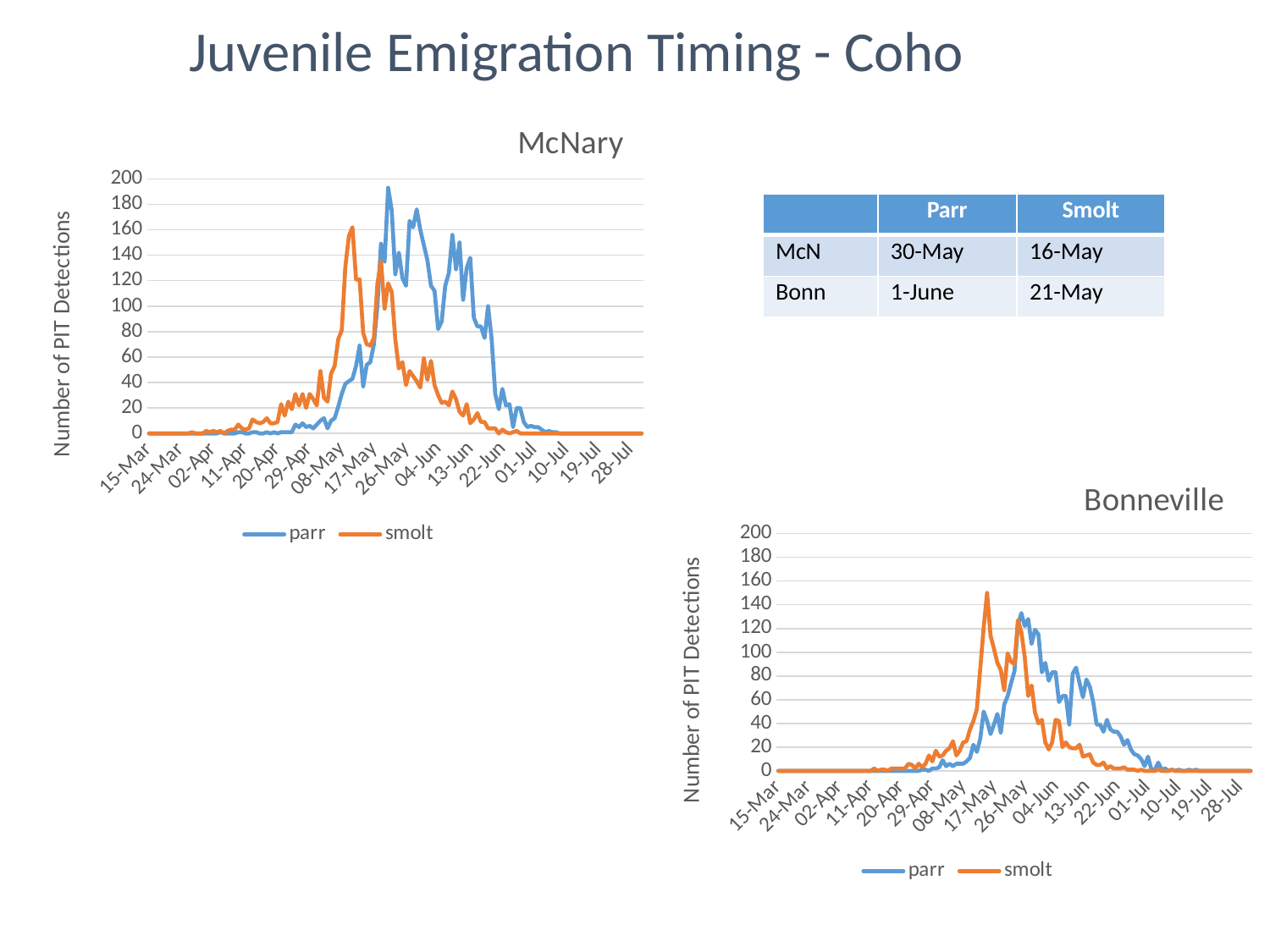
In the McNary chart, which series reaches the higher peak, parr or smolt? parr In the McNary chart, is the peak value of the parr series greater or less than 180? greater What are the two series named in the legend of the McNary chart? parr and smolt In the Bonneville chart, which series reaches the higher peak, parr or smolt? smolt In the Bonneville chart, which series peaks earlier in the season, parr or smolt? smolt What is the y-axis title of the Bonneville chart? Number of PIT Detections How many series does the legend of the Bonneville chart list? 2 In the McNary chart, is the peak value of the smolt series greater or less than 140? greater What type of chart is the McNary chart? line chart What is the highest value shown on the y-axis of the McNary chart? 200 In the Bonneville chart, is the peak value of the smolt series greater or less than 120? greater